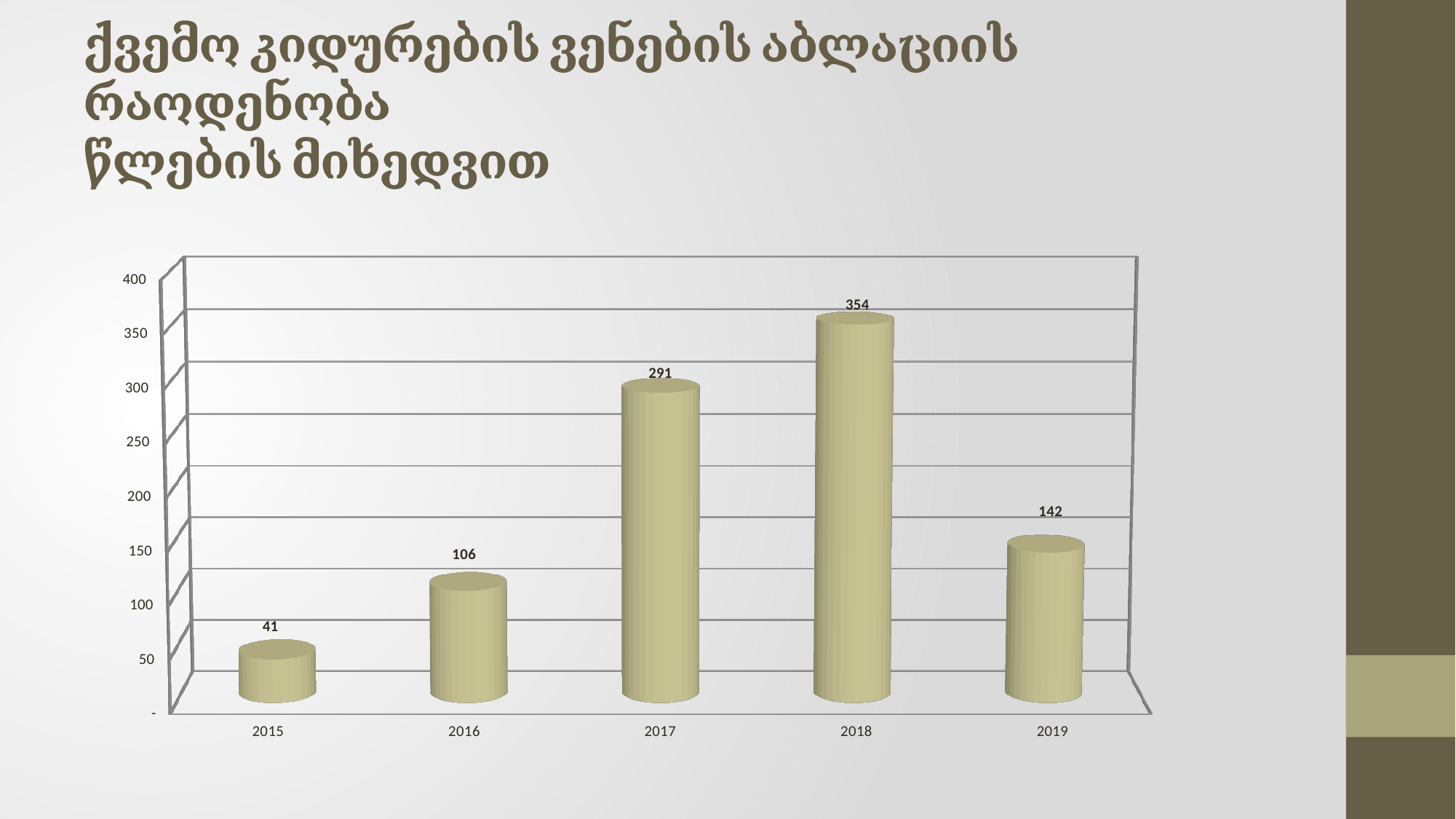
What is the value for 2017? 291 Which is larger, the value for 2016 or the value for 2019? 2019 What is the value for 2019? 142 Which year has the lowest value? 2015 What kind of chart is shown on the slide? bar chart What is the difference between the values for 2018 and 2017? 63 How many years are shown on the x axis? 5 Do the values rise or fall from 2015 to 2018? rise Which year has the highest value? 2018 What is the difference between the values for 2019 and 2016? 36 Is the value for 2017 greater or less than 250? greater What is the value for 2015? 41